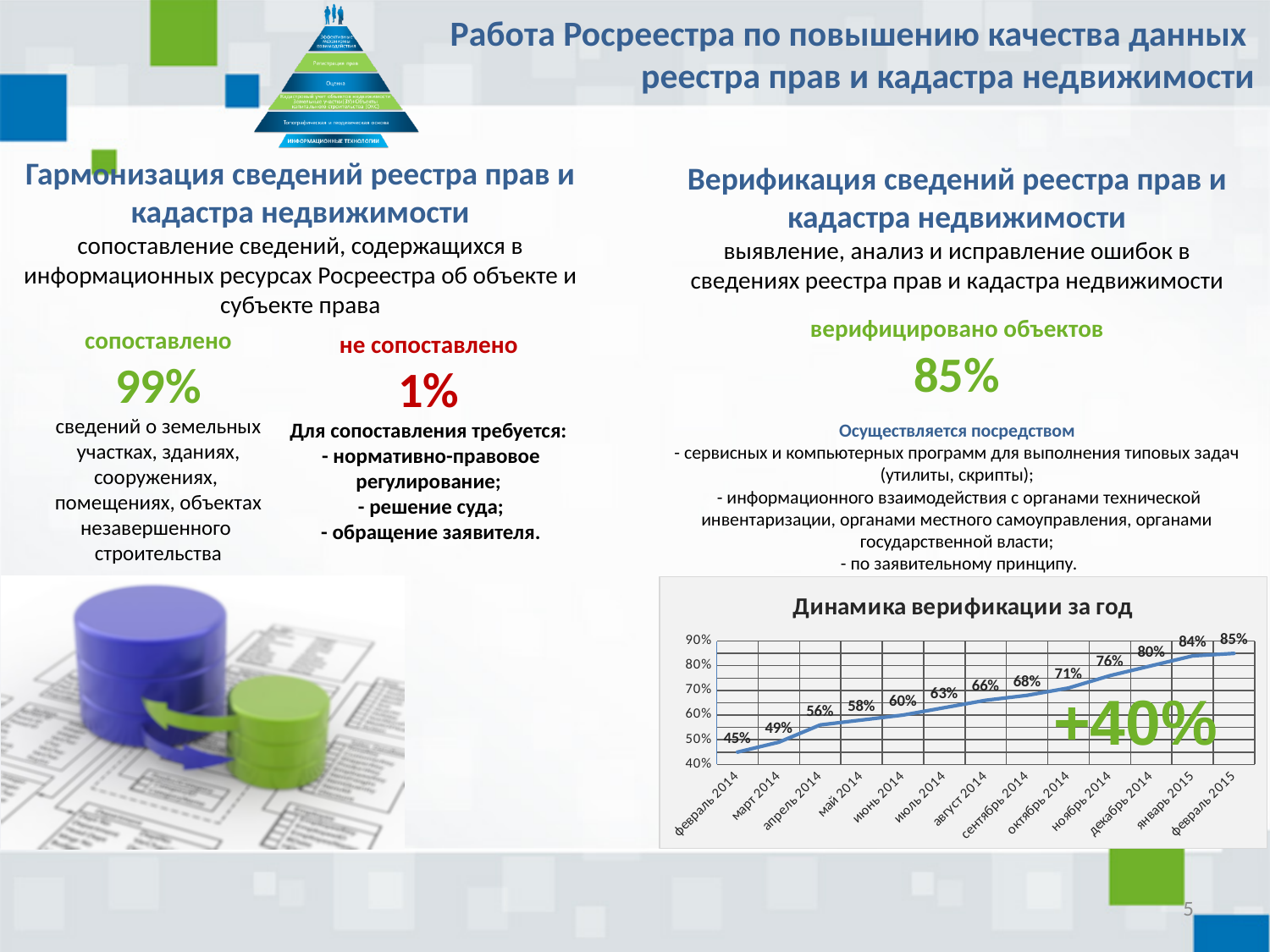
What large annotation is printed over the chart "Динамика верификации за год"? +40% What type of chart is shown under the title "Динамика верификации за год"? line chart In the chart "Динамика верификации за год", which is larger: the value for июль 2014 or the value for ноябрь 2014? ноябрь 2014 What is the value for февраль 2015 in the chart "Динамика верификации за год"? 85% Do the values in the chart "Динамика верификации за год" rise or fall from февраль 2014 to февраль 2015? rise Which month has the lowest value in the chart "Динамика верификации за год"? февраль 2014 In the chart "Динамика верификации за год", what is the difference between the values for декабрь 2014 and сентябрь 2014? 12% What is the value for октябрь 2014 in the chart "Динамика верификации за год"? 71% How many data points are plotted in the chart "Динамика верификации за год"? 13 What is the value for февраль 2014 in the chart "Динамика верификации за год"? 45% In the chart "Динамика верификации за год", what is the difference between the values for февраль 2015 and февраль 2014? 40% Which month has the highest value in the chart "Динамика верификации за год"? февраль 2015